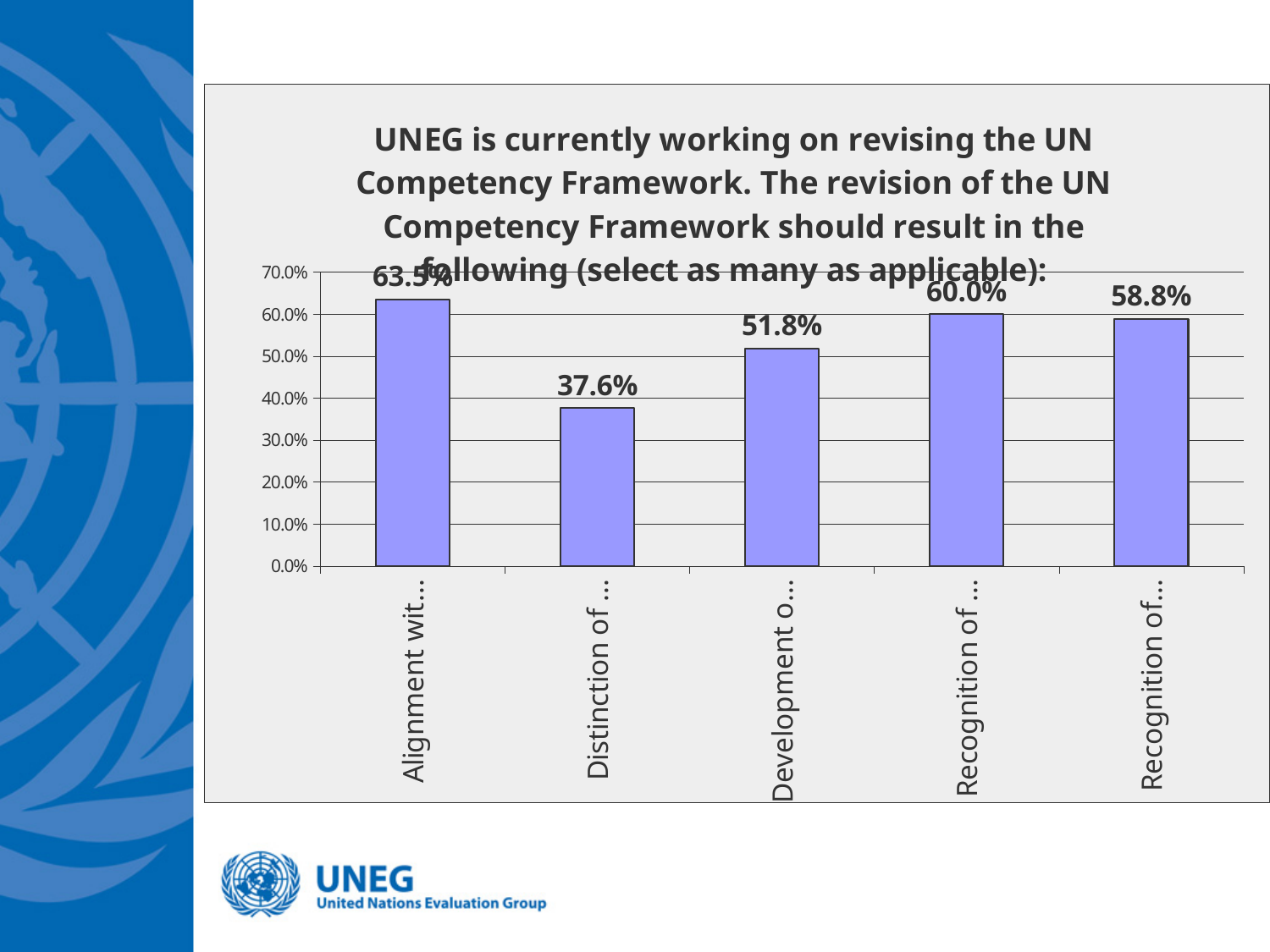
What is the value of the fourth bar from the left? 60.0% Which is larger, the fourth bar or the fifth bar? The fourth bar (60.0%) Which bar has the lowest value? The second bar (Distinction of ...), 37.6% What is the highest value shown on the vertical axis? 70.0% What is the value of the third bar (labelled "Development o...")? 51.8% What kind of chart is shown on the slide? Bar chart What is the value of the first bar (labelled "Alignment wit...")? 63.5% Which bar has the highest value? The first bar (Alignment wit...), 63.5% Is the value of the third bar ("Development o...") greater or less than 50.0%? greater How many bars are shown in the chart? 5 What is the difference between the highest bar (63.5%) and the lowest bar (37.6%)? 25.9 percentage points What is the value of the second bar (labelled "Distinction of ...")? 37.6%